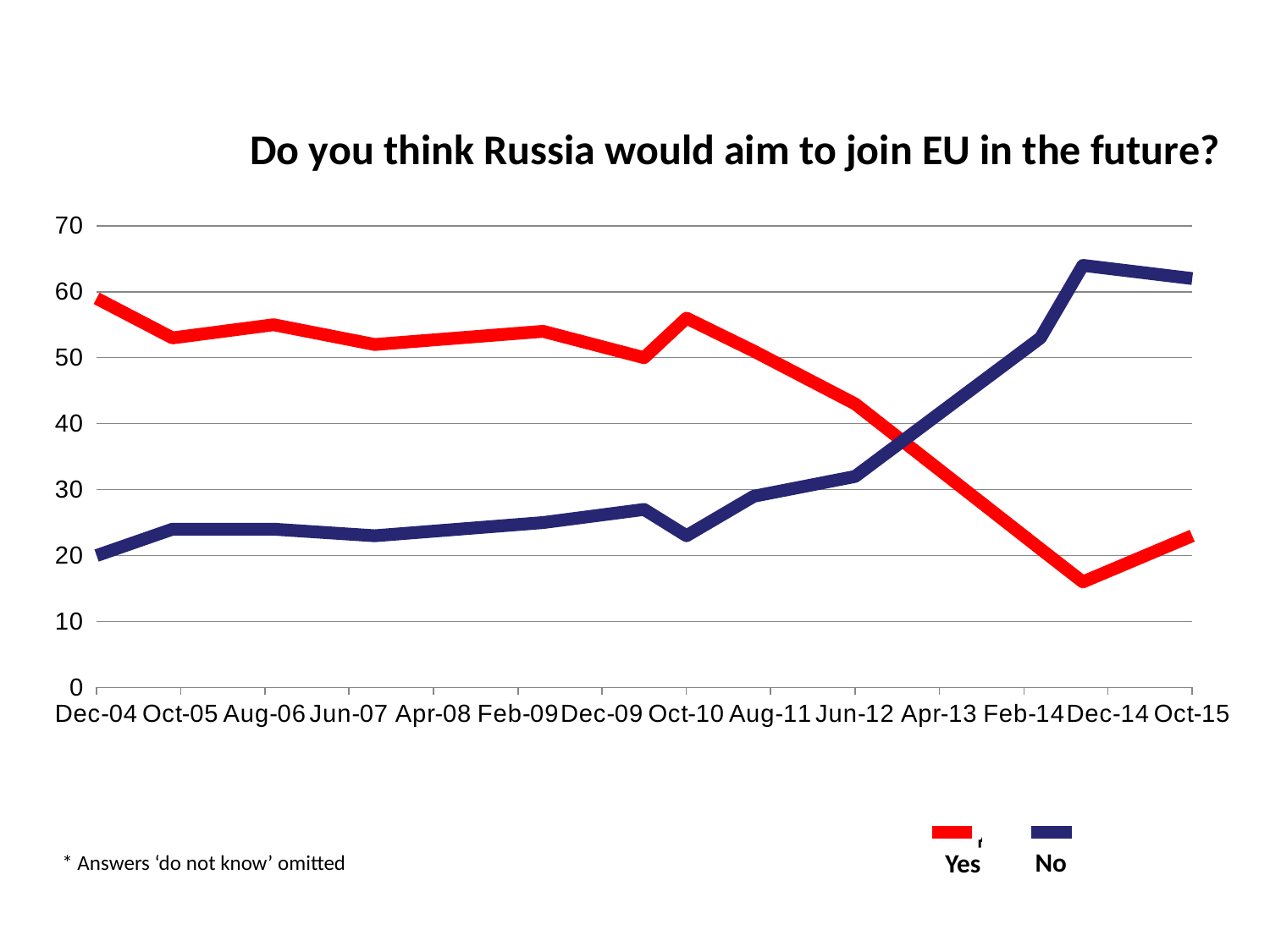
Is the value for 'No' at Dec-04 greater or less than 30? less What is the title of the chart? Do you think Russia would aim to join EU in the future? At which date does the 'Yes' series reach its lowest value? Dec-14 Is the value for 'No' at Oct-15 greater or less than 60? greater Is the value for 'Yes' at Dec-14 greater or less than 20? less What kind of chart is shown on the slide? line chart At Oct-15, which series has the larger value, 'Yes' or 'No'? No Which colour is used for the 'No' series? blue Does the 'No' series generally rise or fall from Dec-04 to Oct-15? rise How many series does the legend list? 2 How many dates are labelled along the x axis? 14